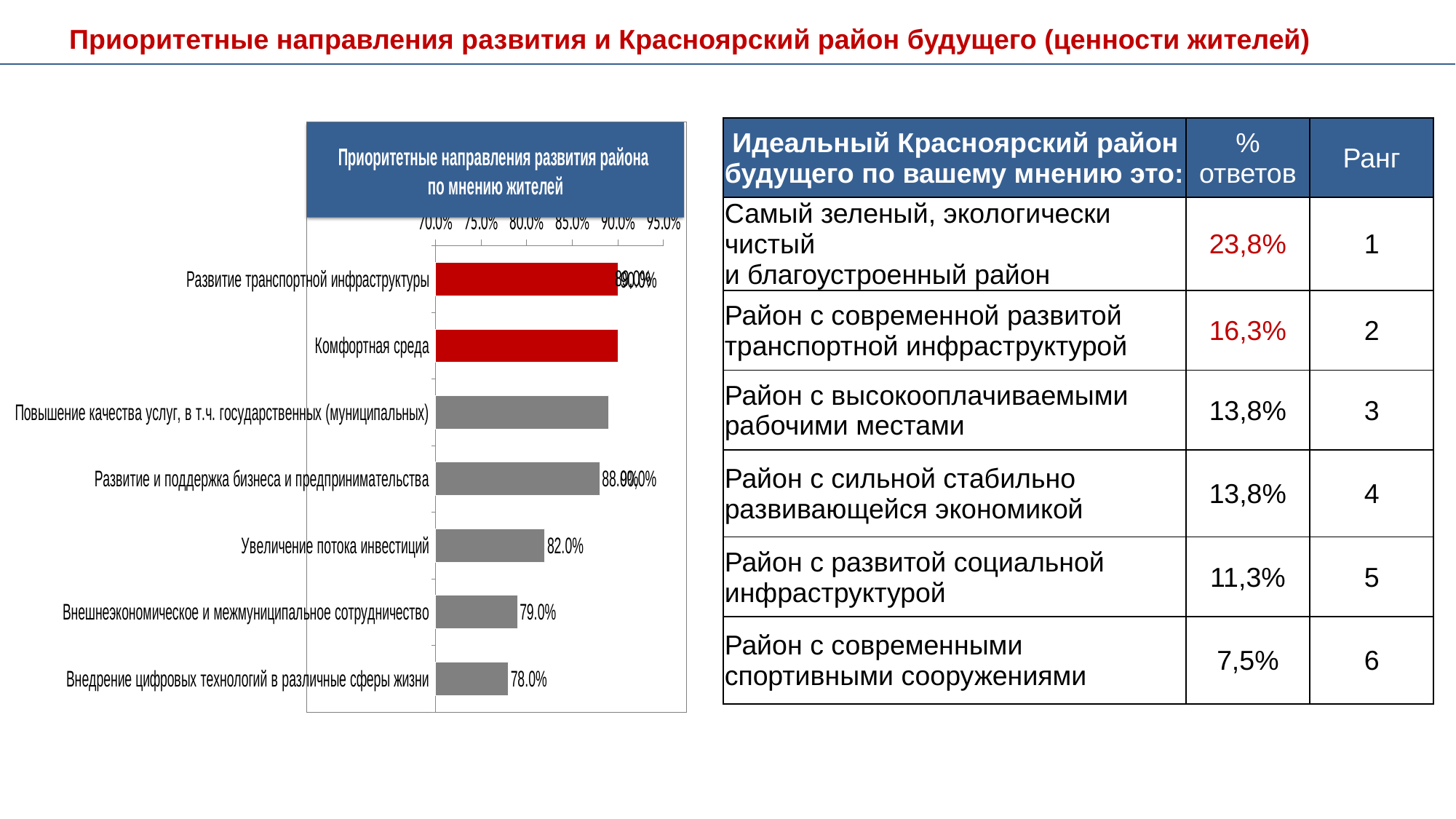
Is the value for Повышение качества услуг, в т.ч. государственных (муниципальных) greater or less than 85.0%? greater What is the value for Внедрение цифровых технологий в различные сферы жизни? 78.0% Is the value for Комфортная среда greater or less than 85.0%? greater What is the difference between the values for Увеличение потока инвестиций and Внешнеэкономическое и межмуниципальное сотрудничество? 3.0% What is the value for Внешнеэкономическое и межмуниципальное сотрудничество? 79.0% What kind of chart is shown on the slide? bar chart Which category has the lowest value in the bar chart? Внедрение цифровых технологий в различные сферы жизни How many bars in the chart are coloured red? 2 What is the value for Увеличение потока инвестиций? 82.0% Which is larger: the value for Увеличение потока инвестиций or the value for Внедрение цифровых технологий в различные сферы жизни? Увеличение потока инвестиций How many categories does the bar chart show? 7 What is the title of the bar chart? Приоритетные направления развития района по мнению жителей